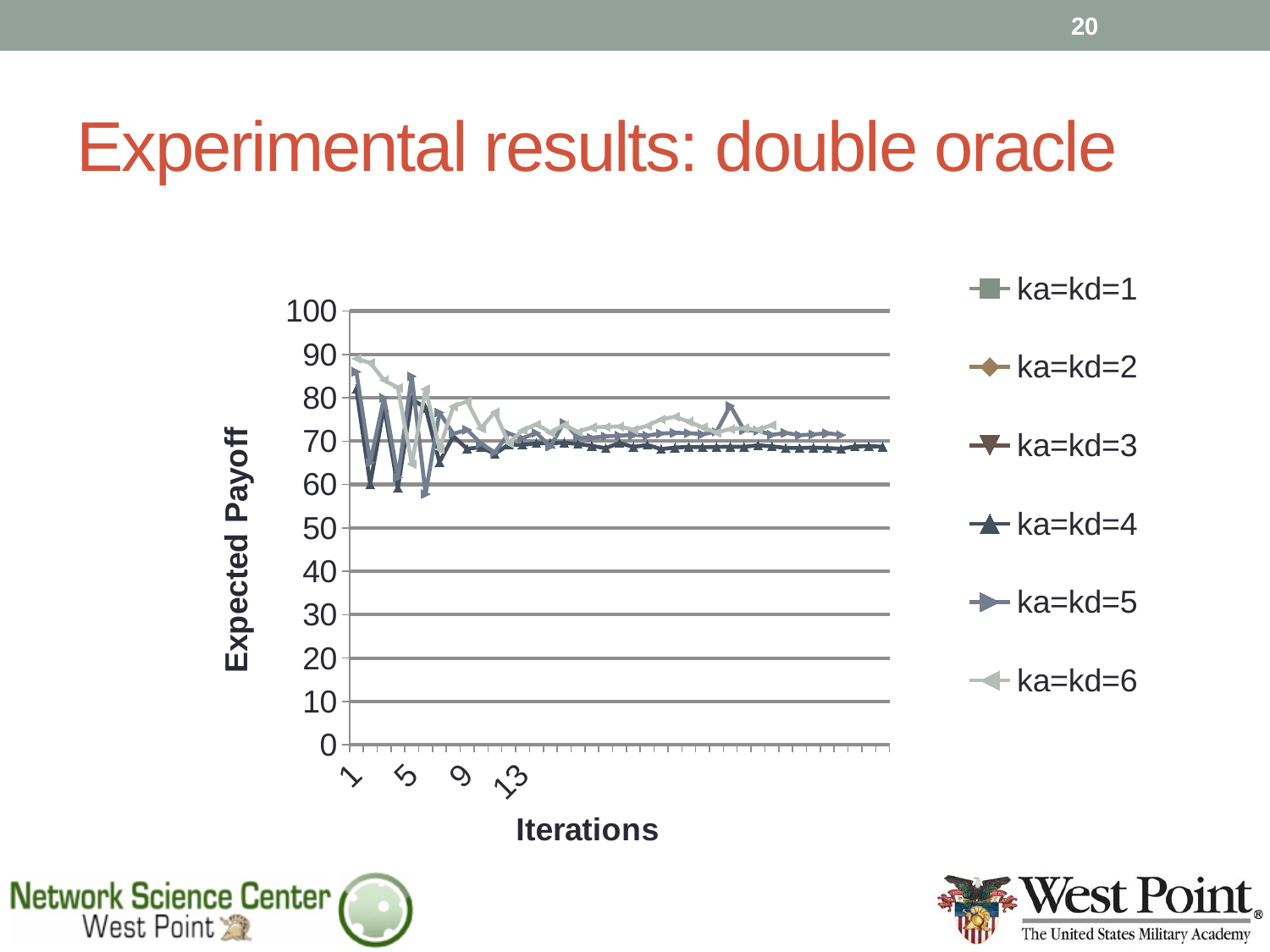
Is the highest plotted value on the chart greater or less than 80? greater What is the highest value shown on the y axis? 100 Around which y-axis gridline do the lines settle in the later iterations: 70 or 40? 70 What is the title of the y axis? Expected Payoff How many series does the legend list? 6 Do the lines fluctuate more at the start or at the end of the iterations? at the start Is the lowest plotted value on the chart greater or less than 50? greater What is the title of the x axis? Iterations Is the value for ka=kd=6 at iteration 1 greater or less than 80? greater What kind of chart is shown on the slide? line chart